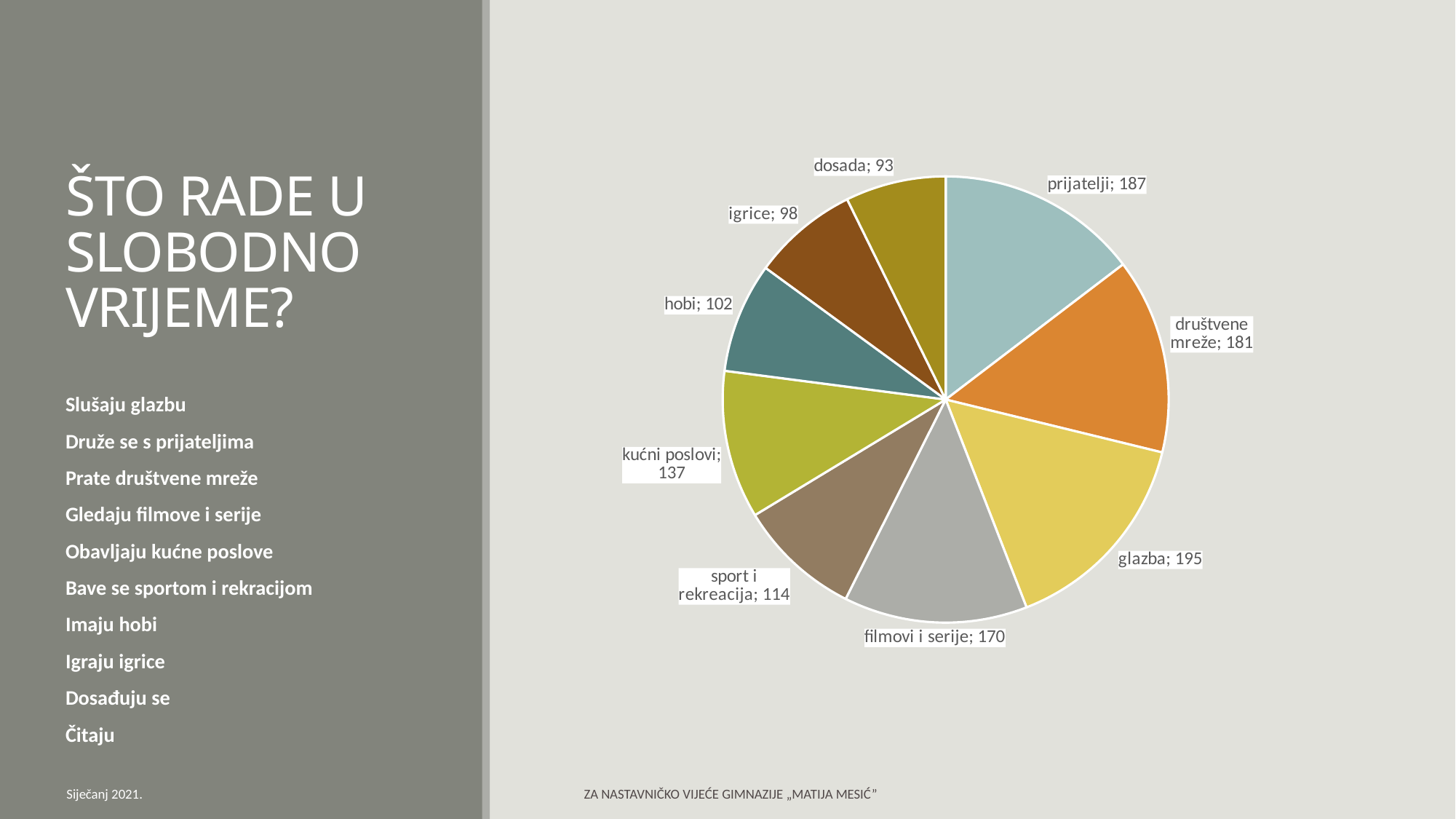
What is the difference between the values for glazba and prijatelji? 8 How many slices does the pie chart have? 9 What is the value for glazba in the pie chart? 195 What is the difference between the values for filmovi i serije and sport i rekreacija? 56 Which category has the smallest value in the pie chart? dosada Which is larger, the value for igrice or the value for hobi? hobi What is the value for sport i rekreacija in the pie chart? 114 What is the value for kućni poslovi in the pie chart? 137 Which is larger, the value for prijatelji or the value for društvene mreže? prijatelji What type of chart is shown on the slide? pie chart What is the value for hobi in the pie chart? 102 Which category has the largest value in the pie chart? glazba